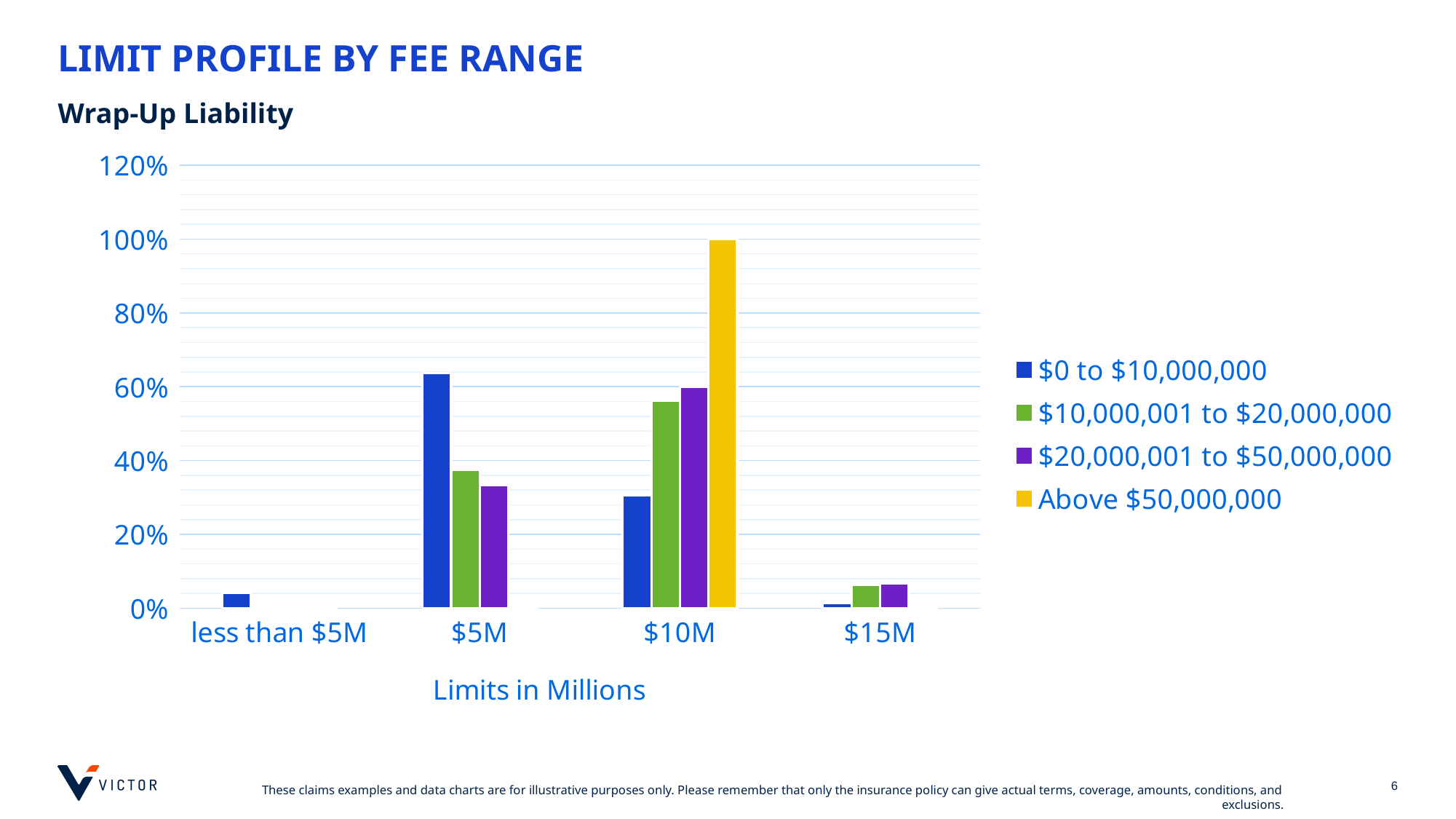
For the $0 to $10,000,000 series, which limit category has the highest value? $5M Which is larger for the $10,000,001 to $20,000,000 series: the value at $5M or the value at $10M? $10M Is the value for the $0 to $10,000,000 series at $10M greater or less than 40%? less How many series does the legend list? 4 Which limit category contains the tallest bar in the chart? $10M What is the x-axis title of the chart? Limits in Millions What is the value for the Above $50,000,000 series at the $10M limit? 100% What kind of chart is shown on the slide? Bar chart How many limit categories are shown on the x axis? 4 Which series is shown in yellow in the legend? Above $50,000,000 Is the value for the $0 to $10,000,000 series at $5M greater or less than 60%? greater Is the value for the $10,000,001 to $20,000,000 series at $5M greater or less than 40%? less